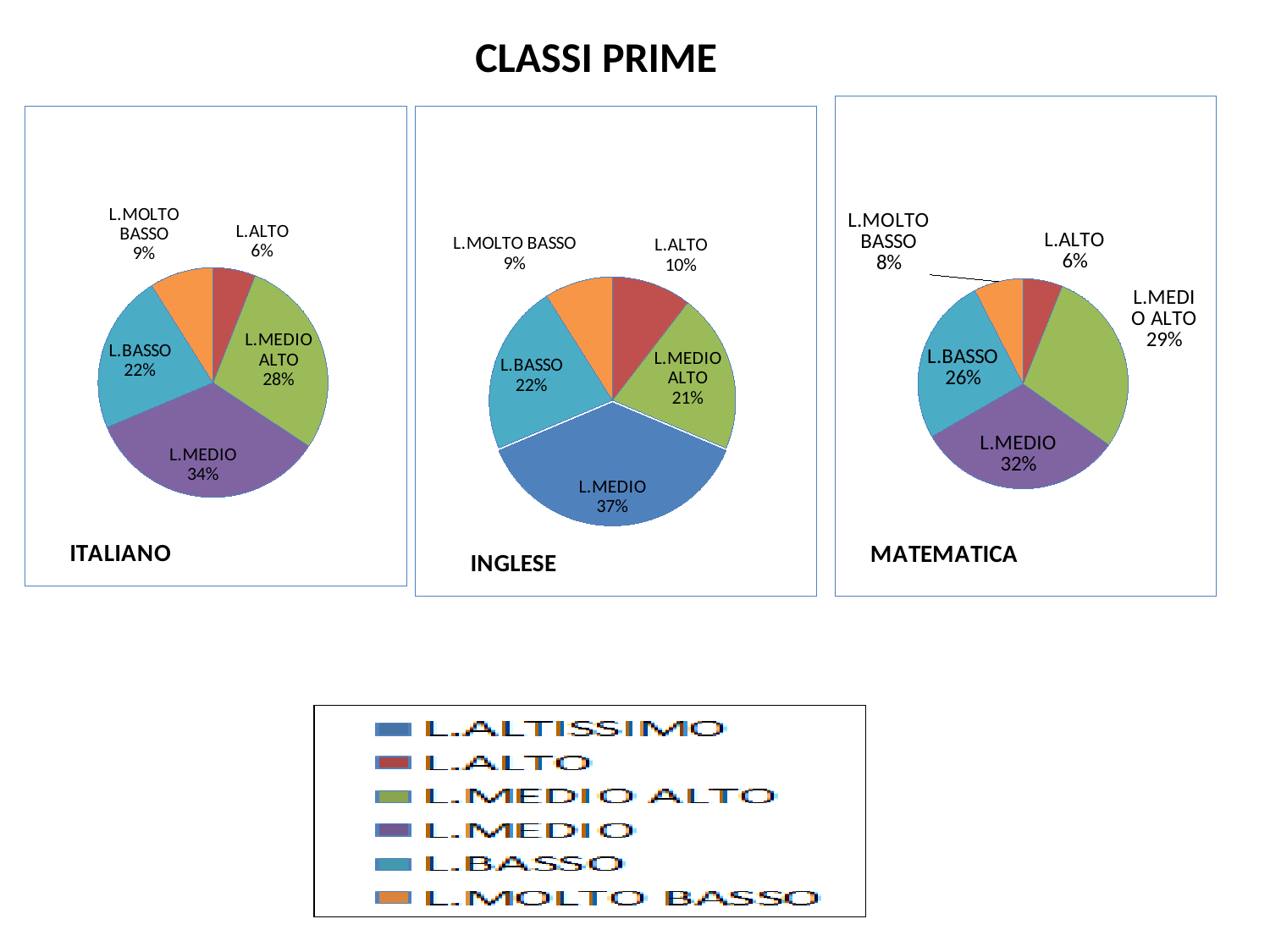
In the MATEMATICA chart, what share does L.BASSO have? 26% In the INGLESE chart, what share does L.MEDIO ALTO have? 21% In the ITALIANO chart, is the L.MEDIO ALTO share larger or smaller than the L.BASSO share? larger How many slices are shown in the INGLESE pie chart? 5 In the MATEMATICA chart, which category has the smallest slice? L.ALTO In the ITALIANO chart, which category has the largest slice? L.MEDIO In the ITALIANO chart, what share does L.MEDIO have? 34% Which is larger: the L.ALTO share in the INGLESE chart or the L.ALTO share in the ITALIANO chart? INGLESE How many entries does the legend at the bottom of the slide list? 6 What type of chart is used for MATEMATICA? Pie chart In the MATEMATICA chart, what is the difference between the L.MEDIO share and the L.MEDIO ALTO share? 3% In the INGLESE chart, what is the difference between the L.MEDIO share and the L.BASSO share? 15%